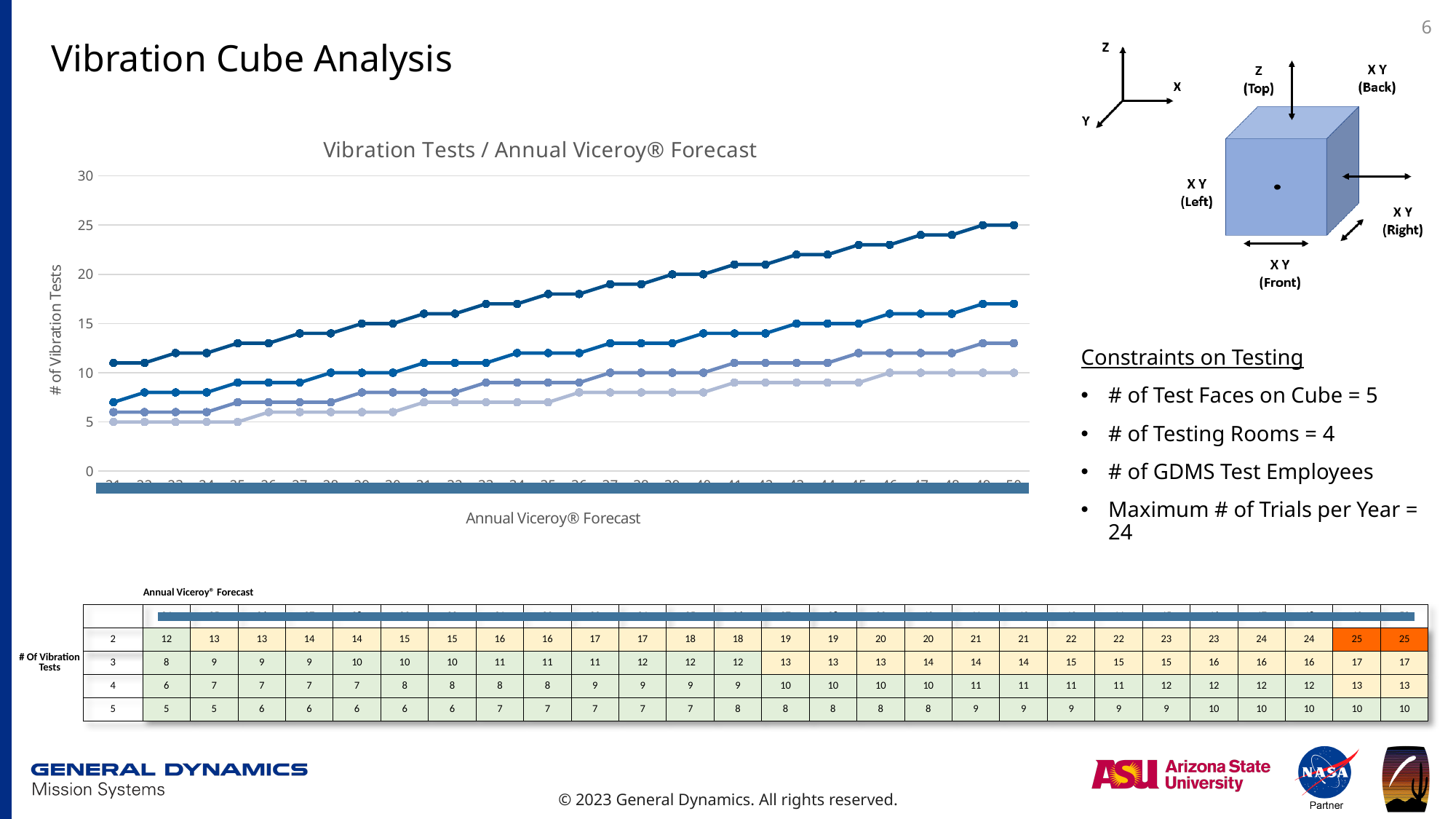
Which line ends at a higher value at the right end of the chart, the topmost line or the bottom line? the topmost line What is the label on the vertical axis of the chart? # of Vibration Tests What is the highest tick value shown on the vertical axis of the chart? 30 Is the starting value of the bottom line greater or less than 10? less What is the lowest value of the bottom line in the chart? 5 How many lines are plotted in the chart? 4 What kind of chart is shown under the title "Vibration Tests / Annual Viceroy® Forecast"? line chart Is the final value of the topmost line greater or less than 20? greater What is the highest value reached by the topmost line in the chart? 25 What is the title of the chart on the slide? Vibration Tests / Annual Viceroy® Forecast Is the final value of the second line from the top greater or less than 15? greater Do the values of the lines in the chart rise or fall as you move from left to right along the x axis? rise